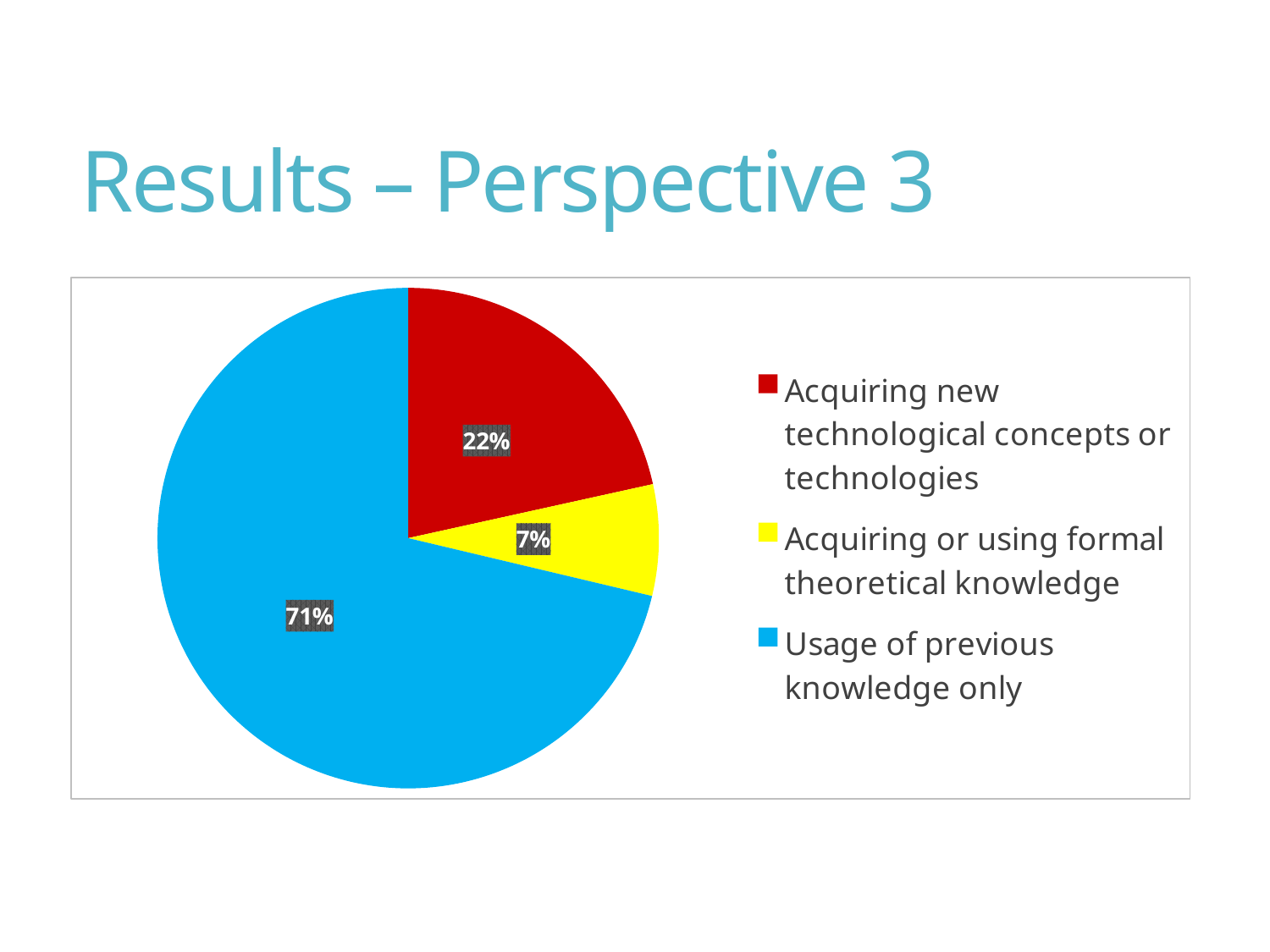
What kind of chart is shown on the slide? pie chart What is the difference in percentage points between "Usage of previous knowledge only" and "Acquiring new technological concepts or technologies"? 49 What share of the pie is labelled "Usage of previous knowledge only"? 71% What share of the pie is labelled "Acquiring new technological concepts or technologies"? 22% What share of the pie is labelled "Acquiring or using formal theoretical knowledge"? 7% Which category has the smallest slice of the pie? Acquiring or using formal theoretical knowledge How many slices does the pie chart have? 3 How many entries does the legend list? 3 What colour is the slice for "Usage of previous knowledge only"? blue Which is larger: the slice for "Acquiring new technological concepts or technologies" or the slice for "Acquiring or using formal theoretical knowledge"? Acquiring new technological concepts or technologies What is the title of the slide containing the pie chart? Results – Perspective 3 Which category has the largest slice of the pie? Usage of previous knowledge only